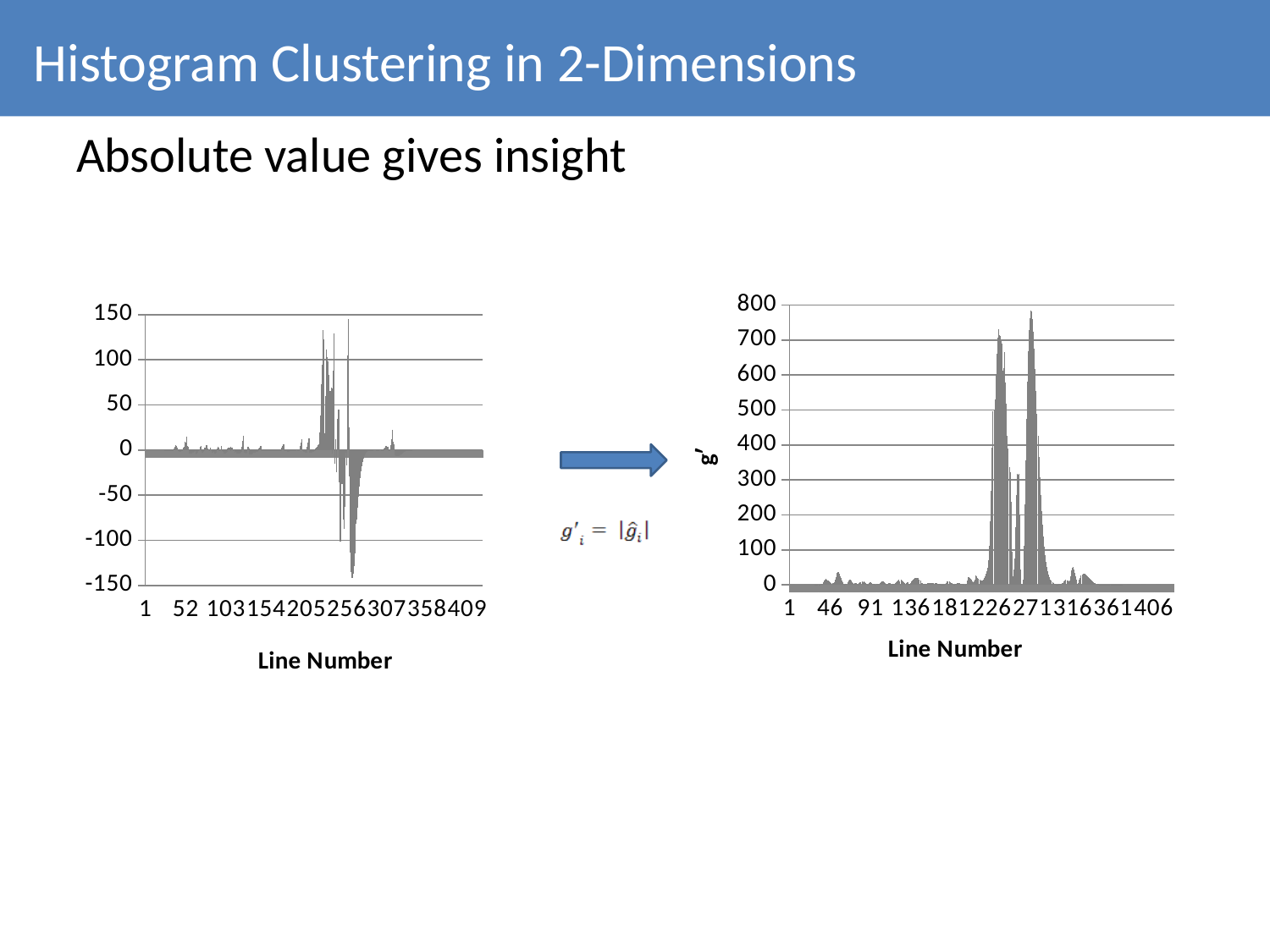
What is the highest value shown on the y-axis of the chart on the right? 800 On the chart on the left, is the highest value greater or less than 100? greater How many tick labels are shown on the x-axis of the chart on the right? 10 What is the y-axis title of the chart on the right? g' On the chart on the left, is the lowest value greater or less than -100? less Does the chart on the right contain any negative values? No On the chart on the right, are the values near line number 46 greater or less than 100? less How many tick labels are shown on the x-axis of the chart on the left? 9